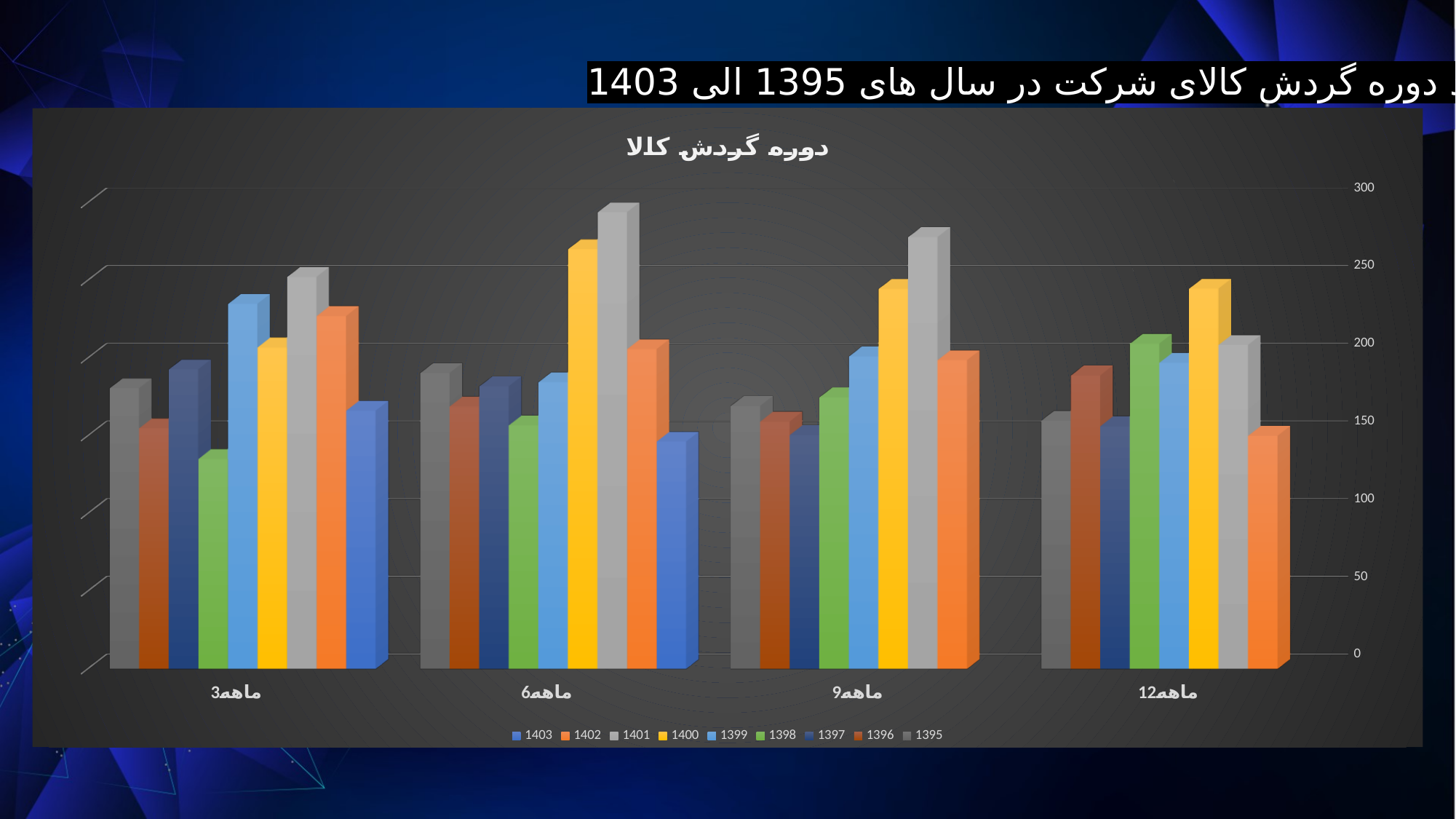
Do the values for the 1398 series rise or fall from 3ماهه to 12ماهه? rise In which category does the 1402 series have its lowest value? 12ماهه Is the value for 1402 in 12ماهه greater or less than 200? less In which category does the 1400 series reach its highest value? 6ماهه How many series does the legend list? 9 Is the value for 1399 in 3ماهه greater or less than 200? greater How many categories are shown on the x axis? 4 Is the value for 1400 in 6ماهه greater or less than 250? greater What is the title of the chart? دوره گردش کالا What kind of chart is shown on the slide? Bar chart Which is larger in 6ماهه, the value for 1400 or the value for 1398? 1400